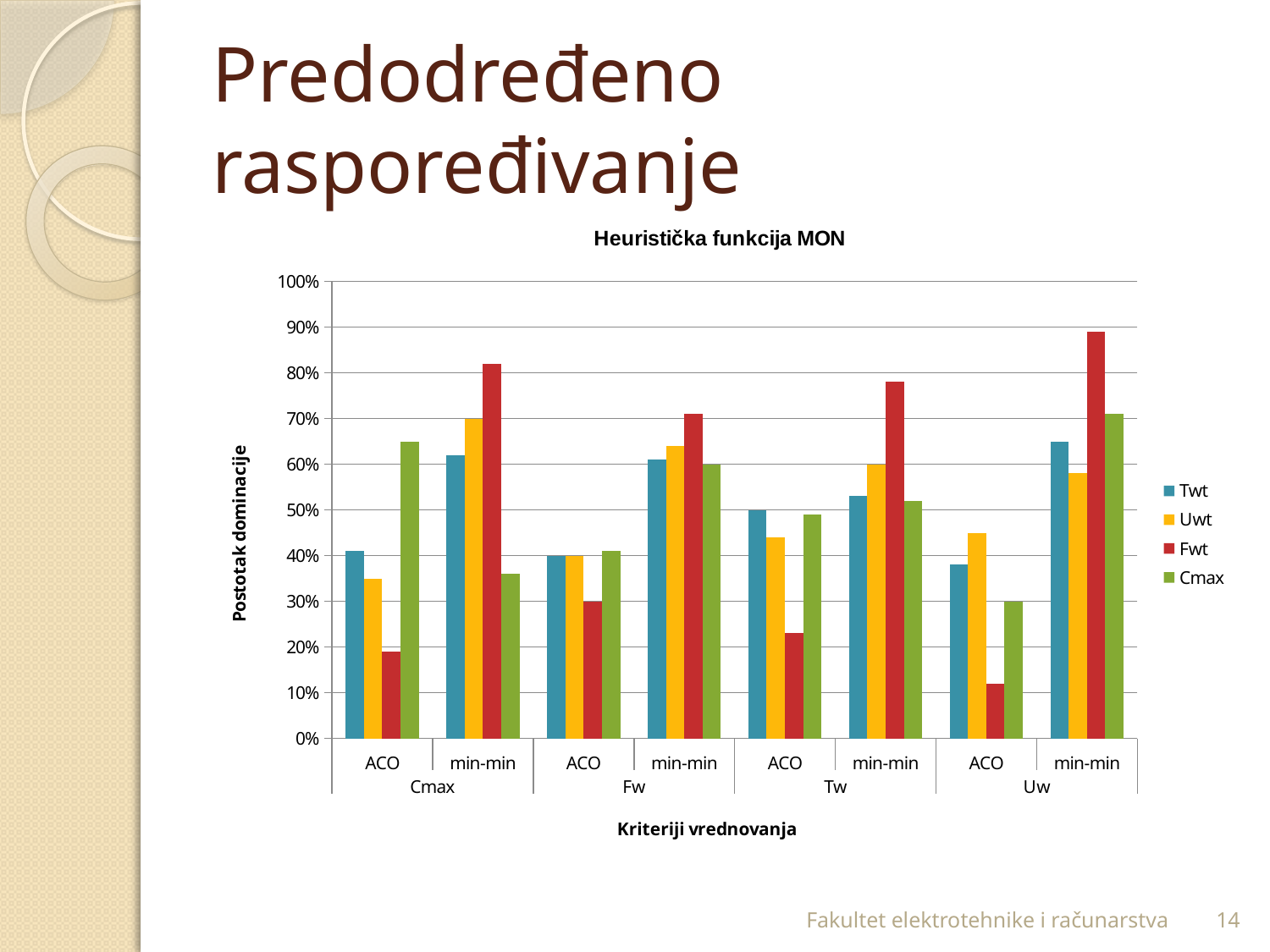
Is the Cmax value for ACO under Cmax greater or less than 60%? greater How many series does the legend list? 4 What kind of chart is shown on the slide? bar chart Which series has the highest bar for min-min under Tw? Fwt For min-min under Cmax, which is larger: the Fwt value or the Cmax value? Fwt What is the label of the vertical axis? Postotak dominacije Which series has the lowest bar for ACO under Tw? Fwt Is the Fwt value for min-min under Uw greater or less than 80%? greater How many evaluation criteria groups (Cmax, Fw, Tw, Uw) are shown along the x axis? 4 Is the Fwt value for ACO under Cmax greater or less than 30%? less What is the title of the chart? Heuristička funkcija MON